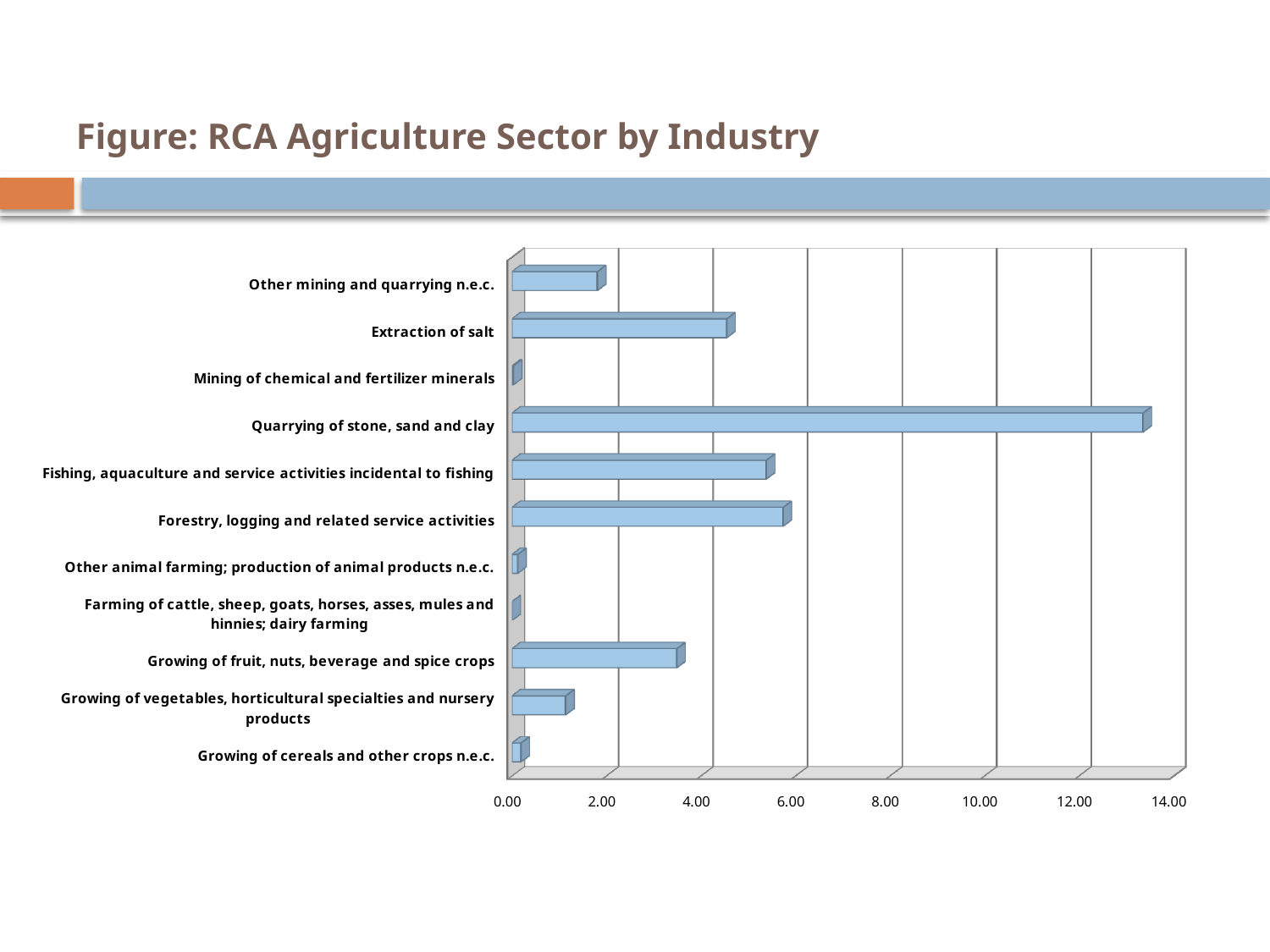
What kind of chart is shown on the slide? Bar chart Which is larger: the value for Growing of vegetables, horticultural specialties and nursery products or the value for Forestry, logging and related service activities? Forestry, logging and related service activities How many industry categories are plotted in the chart? 11 Is the value for Fishing, aquaculture and service activities incidental to fishing greater or less than 4.00? greater Which is larger: the value for Extraction of salt or the value for Growing of fruit, nuts, beverage and spice crops? Extraction of salt Which industry has the highest value in the chart? Quarrying of stone, sand and clay Is the value for Growing of fruit, nuts, beverage and spice crops greater or less than 4.00? less Is the value for Forestry, logging and related service activities greater or less than 6.00? less What is the title of the slide's figure? Figure: RCA Agriculture Sector by Industry